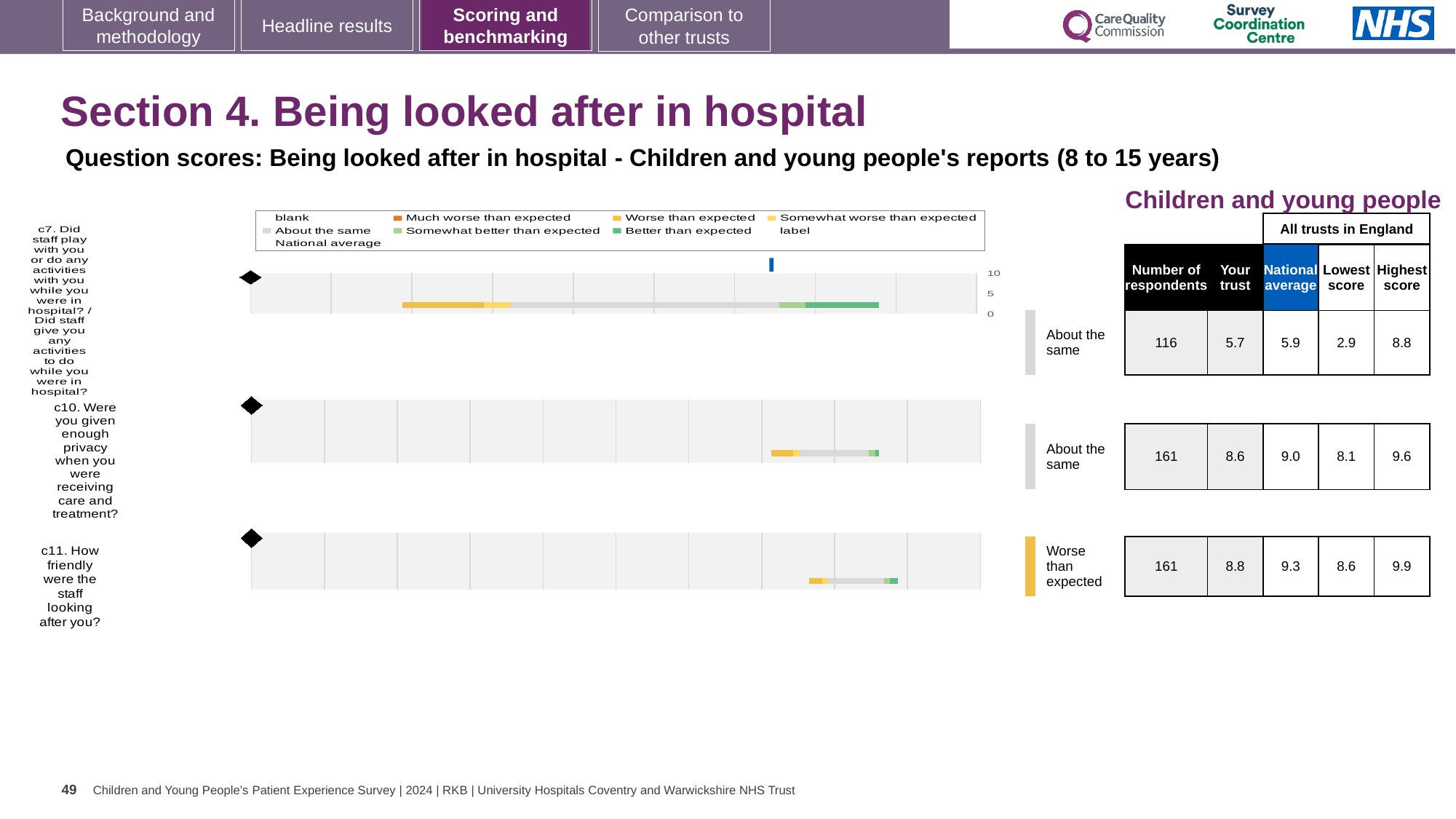
For question c10, which is larger: the 'Your trust' score or the national average? National average How many respondents answered question c11 (How friendly were the staff looking after you?)? 161 What is the highest score across all trusts in England for question c7? 8.8 Which question has the highest 'Your trust' score? c11. How friendly were the staff looking after you? Which benchmark category is question c11 (How friendly were the staff looking after you?) placed in? Worse than expected What is the 'Your trust' score for question c7 (Did staff play with you or do any activities with you while you were in hospital?)? 5.7 What is the lowest score across all trusts in England for question c10? 8.1 What is the national average score for question c10 (Were you given enough privacy when you were receiving care and treatment?)? 9.0 For question c7, what is the difference between the national average and the 'Your trust' score? 0.2 What kind of chart is used to show the question scores on this slide? bar chart How many questions are plotted in the chart on this slide? 3 Which question has the lowest 'Your trust' score? c7. Did staff play with you or do any activities with you while you were in hospital?